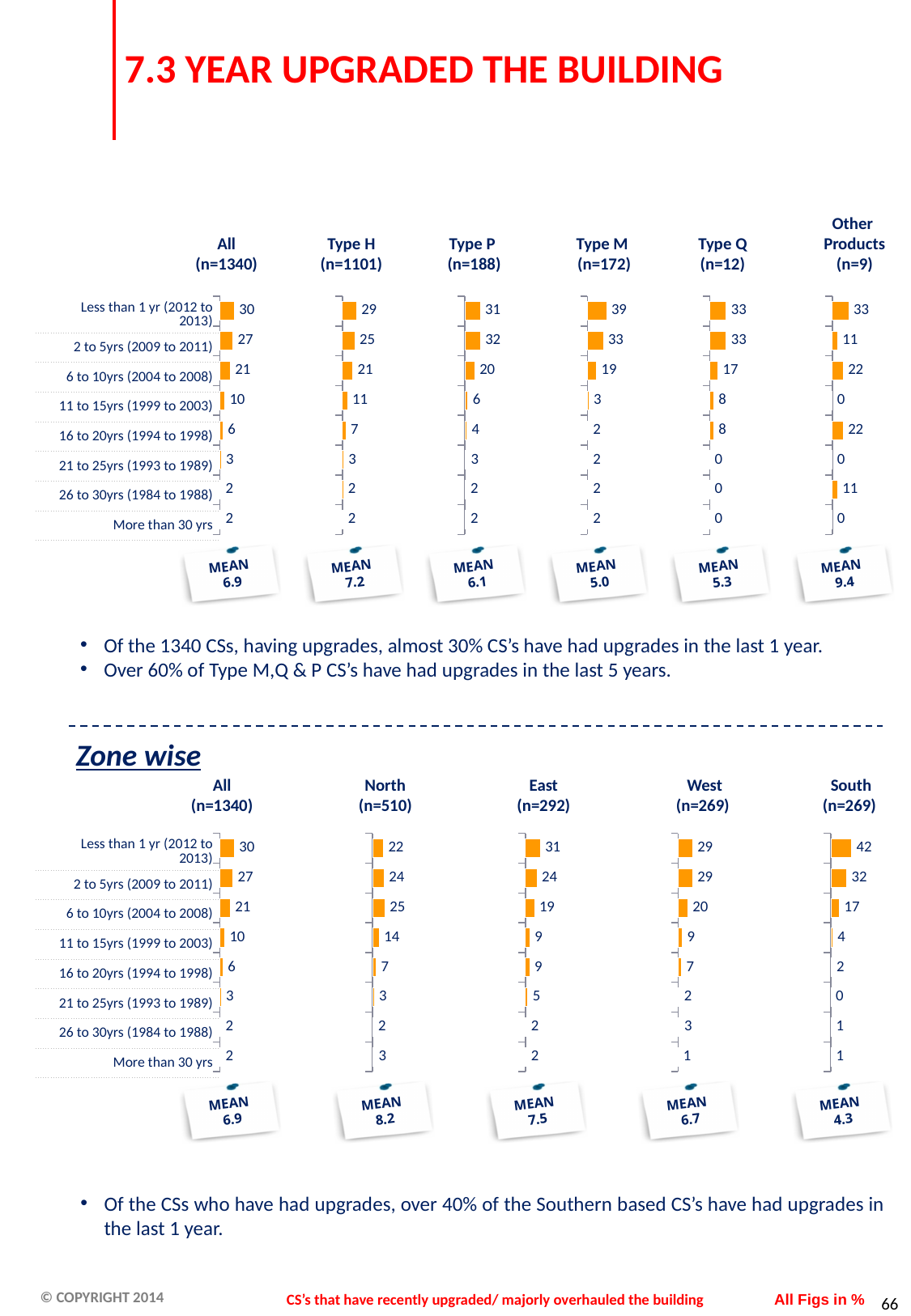
In the top section, in the Type H (n=1101) chart, what is the difference between 'Less than 1 yr (2012 to 2013)' and '2 to 5yrs (2009 to 2011)'? 4 What kind of chart is used in the Zone wise section? Bar chart In the top section, which is larger: the 'Less than 1 yr (2012 to 2013)' value for Type M or for Type Q? Type M In the Zone wise section, in the North (n=510) chart, which category has the highest value? 6 to 10yrs (2004 to 2008) In the top section, in the Type M (n=172) chart, what is the value for 'Less than 1 yr (2012 to 2013)'? 39 In the Zone wise section, in the South (n=269) chart, what is the value for 'Less than 1 yr (2012 to 2013)'? 42 In the top section, in the Type P (n=188) chart, which category has the highest value? 2 to 5yrs (2009 to 2011) In the Zone wise section, in the West (n=269) chart, do the values generally rise or fall from 'Less than 1 yr' to 'More than 30 yrs'? Fall In the Zone wise section, what is the MEAN shown for the East (n=292) chart? 7.5 How many categories are shown in each chart in the top section? 8 In the Zone wise section, what is the difference between the 'Less than 1 yr (2012 to 2013)' values for South and North? 20 In the top section, in the Other Products (n=9) chart, what is the value for '16 to 20yrs (1994 to 1998)'? 22